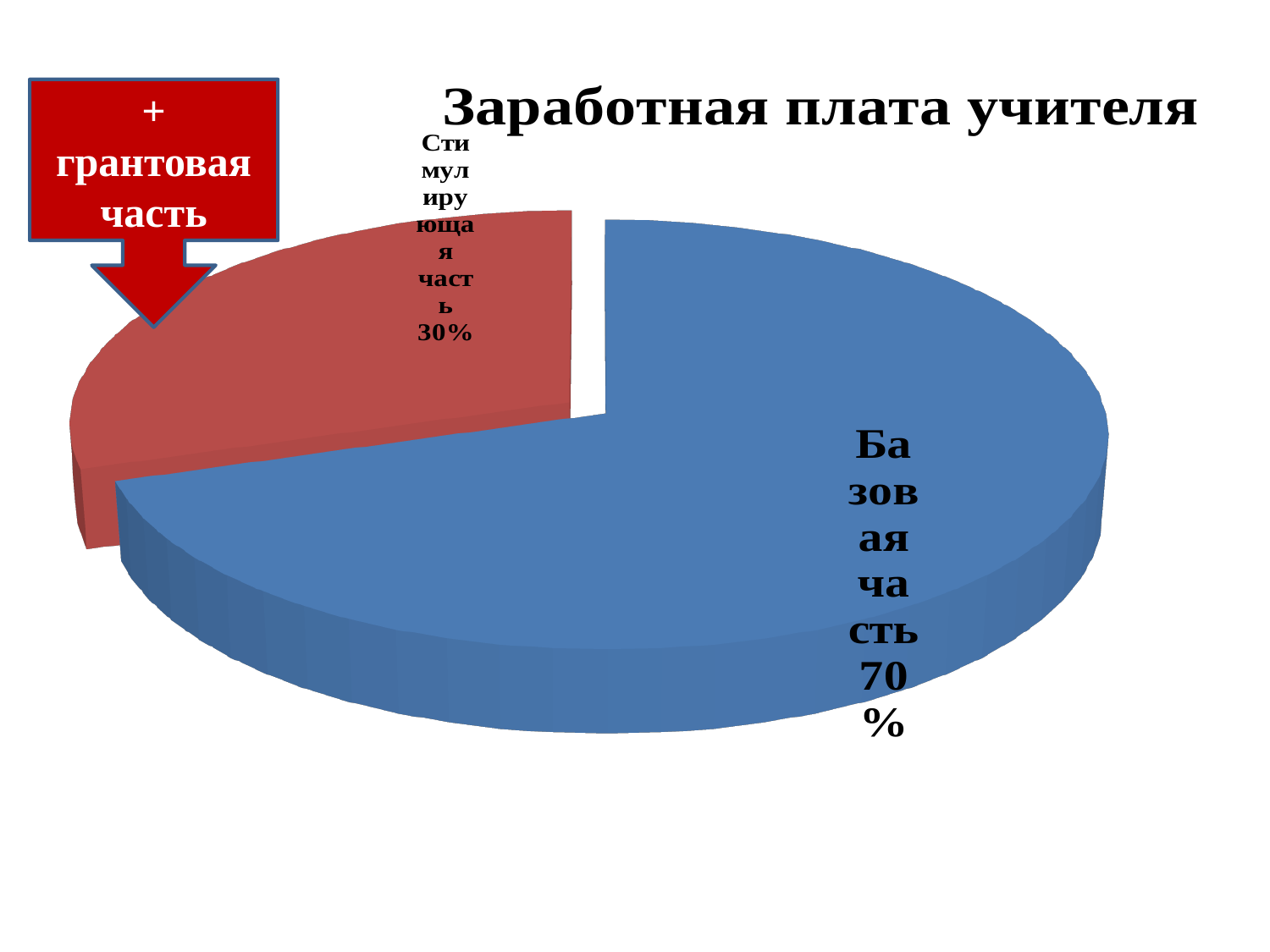
What is the title of the chart? Заработная плата учителя What is the difference in percentage points between Базовая часть and Стимулирующая часть? 40% What colour is the Базовая часть slice? blue What share of the pie is Стимулирующая часть? 30% Which slice of the pie is the largest? Базовая часть What kind of chart is shown on the slide? pie chart How many slices does the pie chart have? 2 What share of the pie is Базовая часть? 70% Is the share for Стимулирующая часть greater or less than 50%? less Which is larger, Базовая часть or Стимулирующая часть? Базовая часть Which slice of the pie is the smallest? Стимулирующая часть